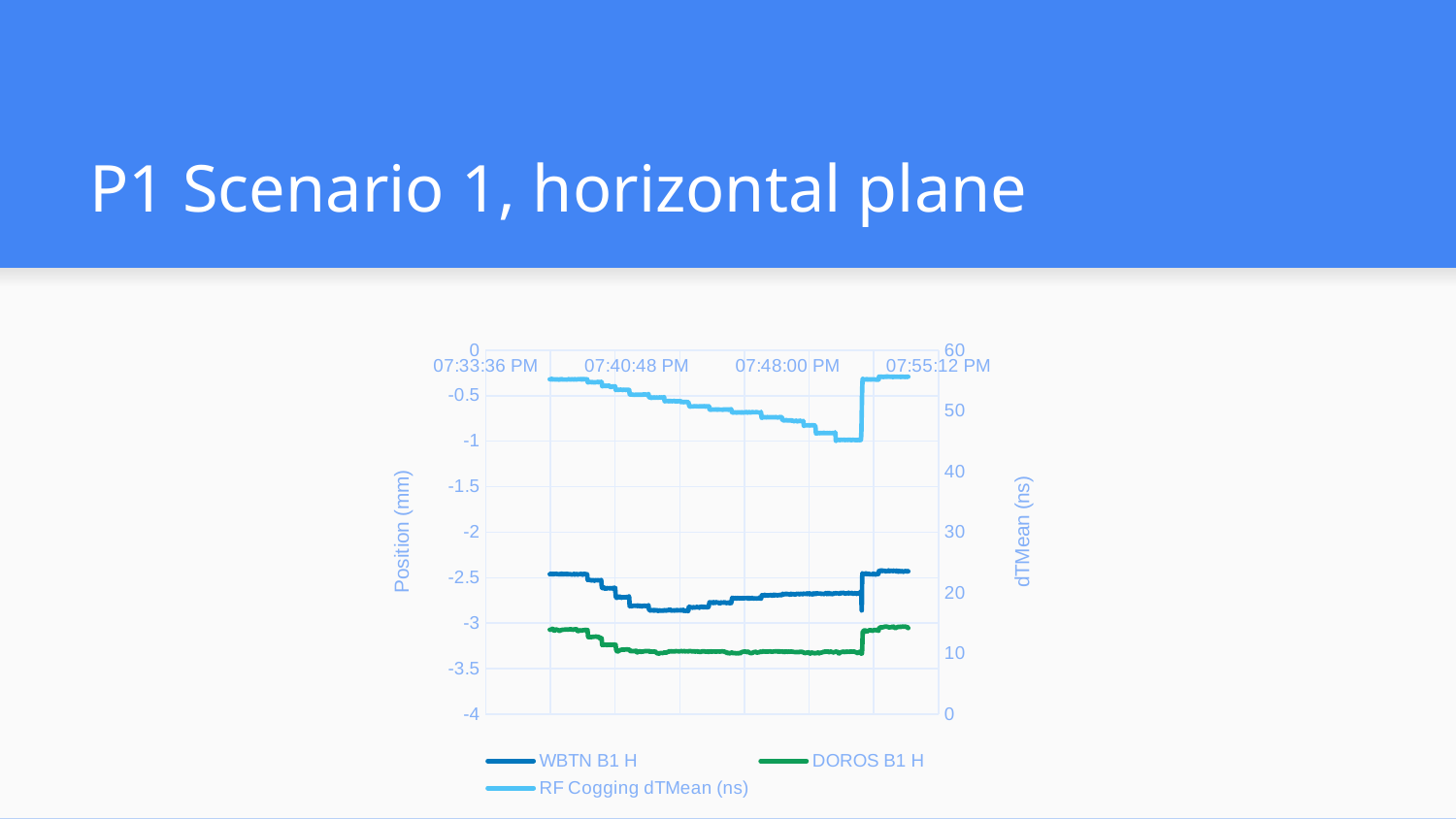
Is the RF Cogging dTMean value at the start of the chart greater or less than 50 ns? greater How many series does the legend list? 3 Is the DOROS B1 H position around 07:48:00 PM greater or less than -3 mm? less Does the RF Cogging dTMean series rise or fall between 07:33:36 PM and 07:48:00 PM? fall Which series has the higher position values throughout the chart, WBTN B1 H or DOROS B1 H? WBTN B1 H Is the DOROS B1 H position at the start of the chart greater or less than -3.5 mm? greater What is the title of the left vertical axis? Position (mm) Which series is plotted in green? DOROS B1 H What kind of chart is shown on the slide? line chart What is the title of the right vertical axis? dTMean (ns)